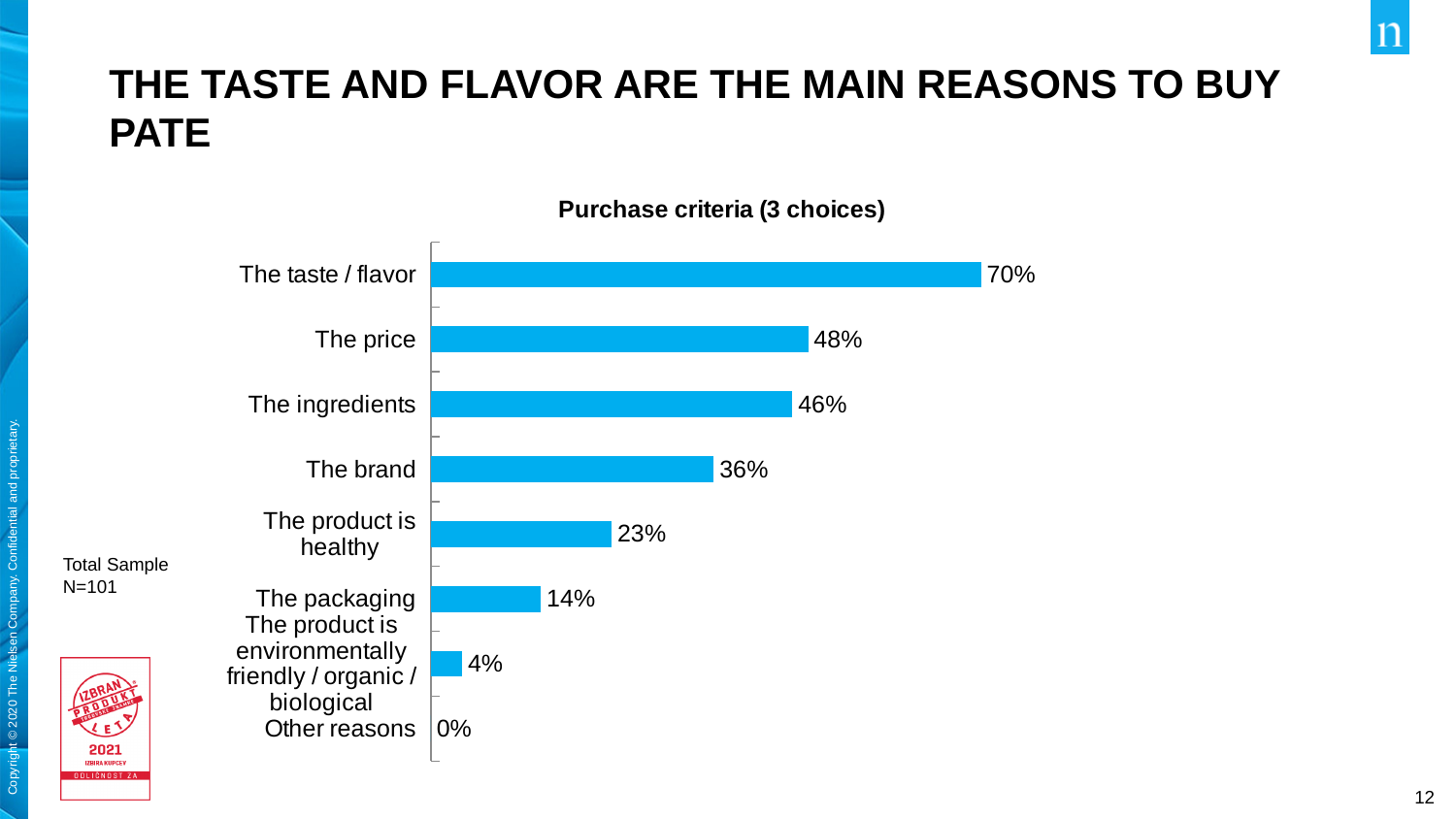
What is the difference between The taste / flavor and The brand? 34% What kind of chart is shown on the slide? Bar chart What is the title of the chart? Purchase criteria (3 choices) What is the value for The taste / flavor? 70% Which is larger, The brand or The product is healthy? The brand What is the value for The product is healthy? 23% Which purchase criterion has the lowest value? Other reasons Which purchase criterion has the highest value? The taste / flavor What is the value for The price? 48% What is the value for The packaging? 14% What is the difference between The price and The ingredients? 2% How many purchase criteria are shown in the chart? 8